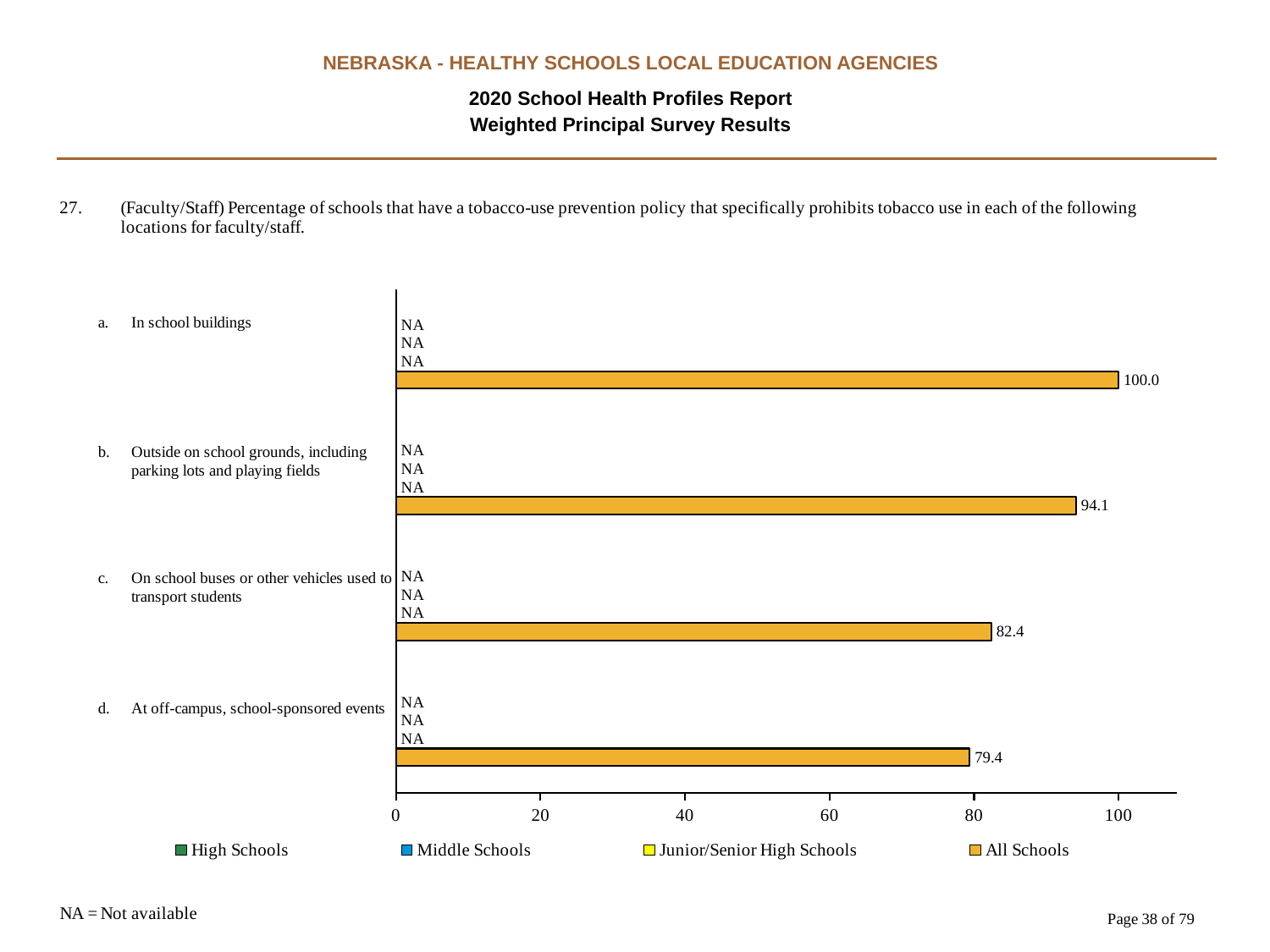
What is the All Schools value for 'In school buildings'? 100.0 What is the All Schools value for 'At off-campus, school-sponsored events'? 79.4 Which has a larger All Schools value: 'Outside on school grounds, including parking lots and playing fields' or 'On school buses or other vehicles used to transport students'? Outside on school grounds, including parking lots and playing fields Which location has the highest All Schools value? In school buildings What is the All Schools value for 'Outside on school grounds, including parking lots and playing fields'? 94.1 How many locations (categories) are shown in the chart? 4 Which location has the lowest All Schools value? At off-campus, school-sponsored events How many series does the legend list? 4 What value is shown for High Schools for 'In school buildings'? NA What kind of chart is shown on the slide? Bar chart What is the difference between the All Schools values for 'In school buildings' and 'At off-campus, school-sponsored events'? 20.6 What is the All Schools value for 'On school buses or other vehicles used to transport students'? 82.4